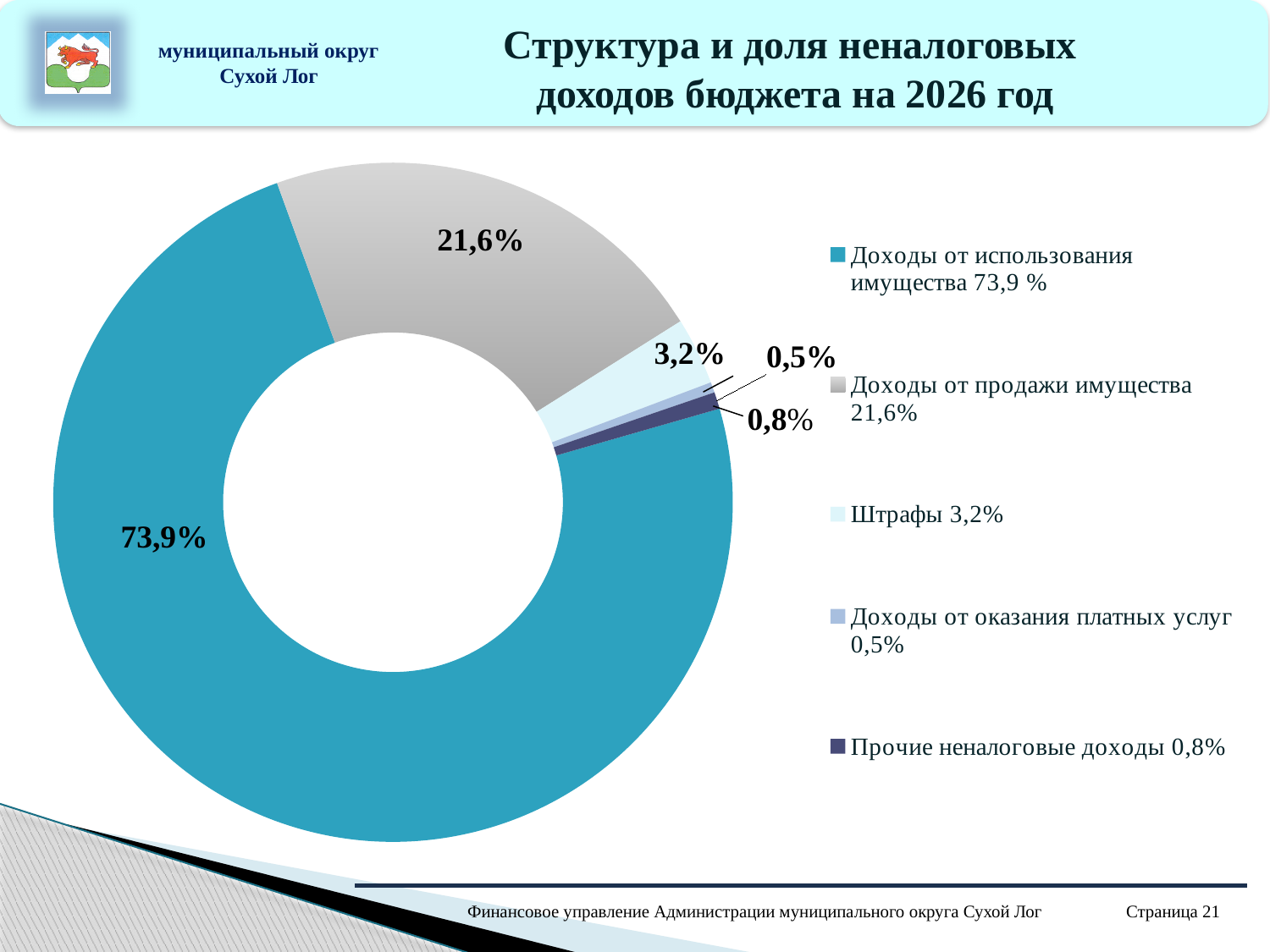
Which category has the smallest share of the chart? Доходы от оказания платных услуг What is the difference between Штрафы and Прочие неналоговые доходы? 2,4% Which is larger: Прочие неналоговые доходы or Доходы от оказания платных услуг? Прочие неналоговые доходы What share does Доходы от продажи имущества have in the chart? 21,6% What is the difference in percentage points between Доходы от использования имущества and Доходы от продажи имущества? 52,3% How many categories does the chart show? 5 What type of chart is shown on the slide? doughnut chart Which category has the largest share of the chart? Доходы от использования имущества What is the value for Прочие неналоговые доходы? 0,8% What share is shown for Доходы от оказания платных услуг? 0,5% What share of non-tax revenue comes from Доходы от использования имущества? 73,9% What is the value shown for Штрафы? 3,2%